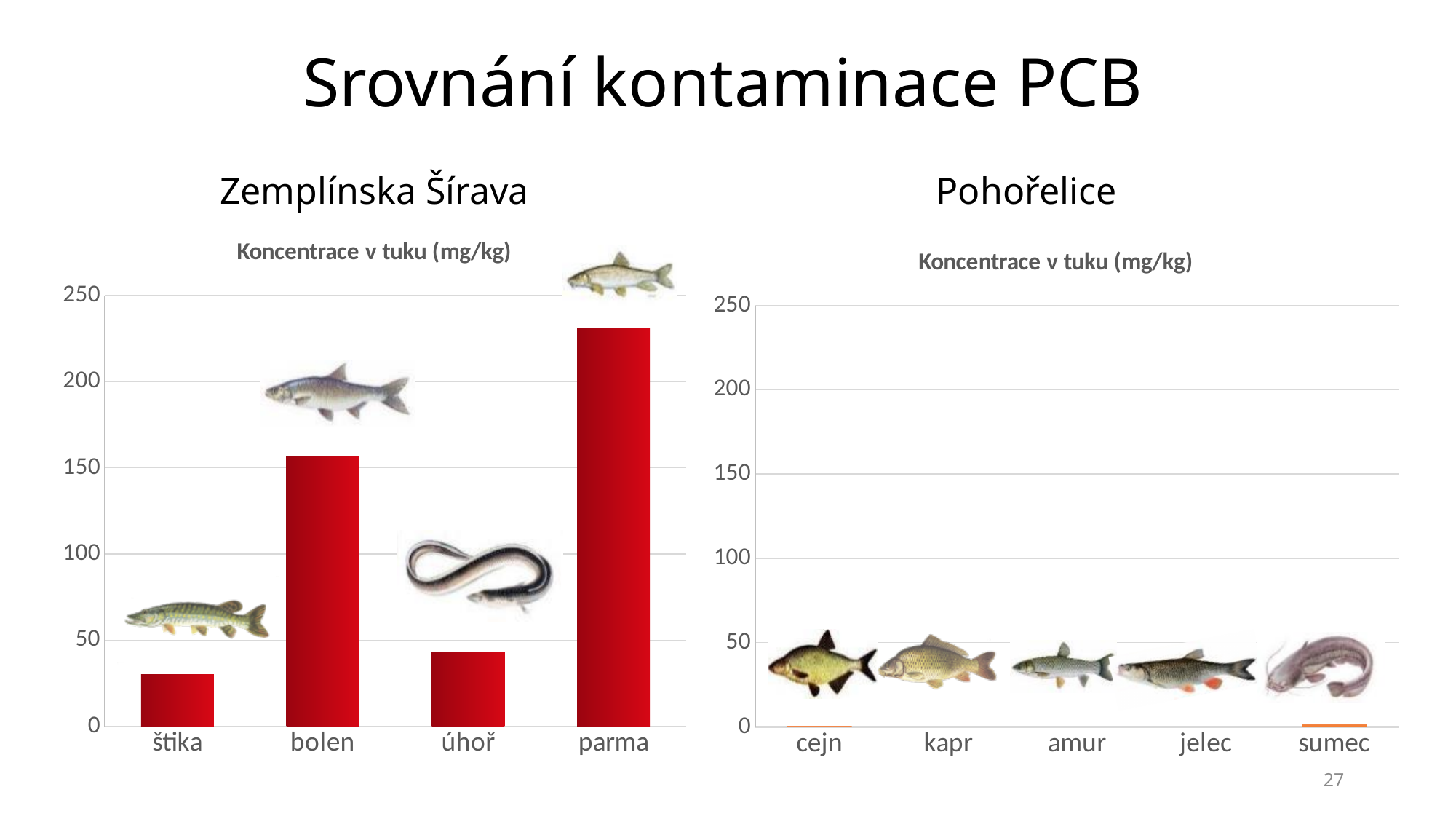
On the Zemplínska Šírava chart, is the value for bolen greater or less than 150? greater On the Zemplínska Šírava chart, which fish has the lowest concentration? štika How many fish species are shown on the Pohořelice chart? 5 How many fish species are shown on the Zemplínska Šírava chart? 4 What is the title shown above the Pohořelice chart's plot area? Koncentrace v tuku (mg/kg) On the Zemplínska Šírava chart, which fish has the highest concentration? parma What colour are the bars on the Zemplínska Šírava chart? red What kind of chart is the Zemplínska Šírava chart? bar chart On the Zemplínska Šírava chart, is the value for štika greater or less than 50? less On the Pohořelice chart, is the value for kapr greater or less than 50? less On the Zemplínska Šírava chart, which has a higher concentration, bolen or úhoř? bolen